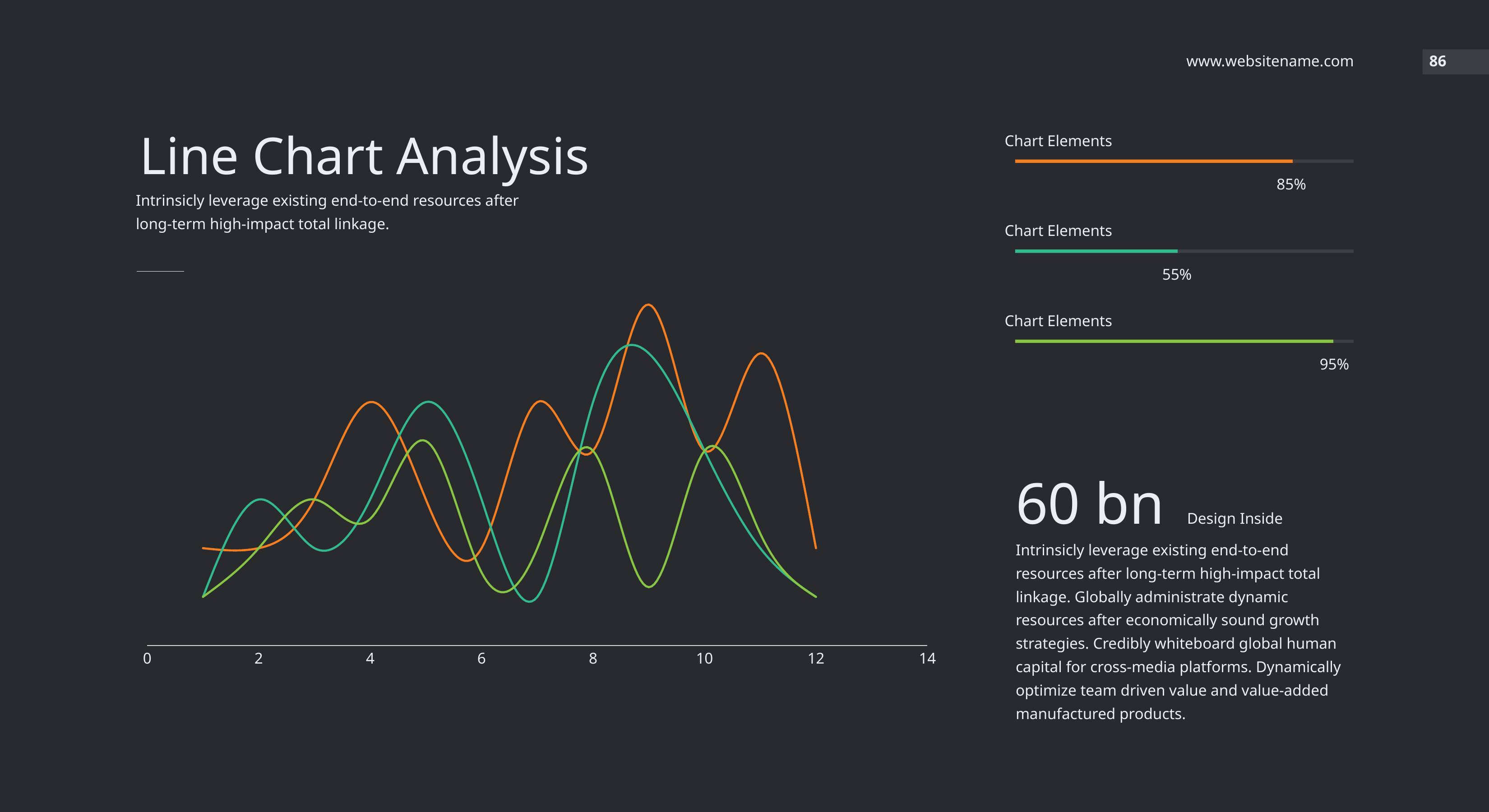
Does the teal line rise or fall between x = 7 and x = 9? rise How many lines are plotted on the line chart? 3 What is the interval between consecutive tick labels on the x axis? 2 What kind of chart is shown on the slide? line chart How many tick labels are shown on the x axis of the line chart? 8 What colours are the three lines on the chart? orange, teal and green Which line reaches the highest peak on the chart? the orange line What is the lowest value labelled on the x axis of the line chart? 0 What is the title of the line chart slide? Line Chart Analysis At x = 4, which is higher, the orange line or the green line? the orange line Does the orange line rise or fall between x = 11 and x = 12? fall What is the highest value labelled on the x axis of the line chart? 14